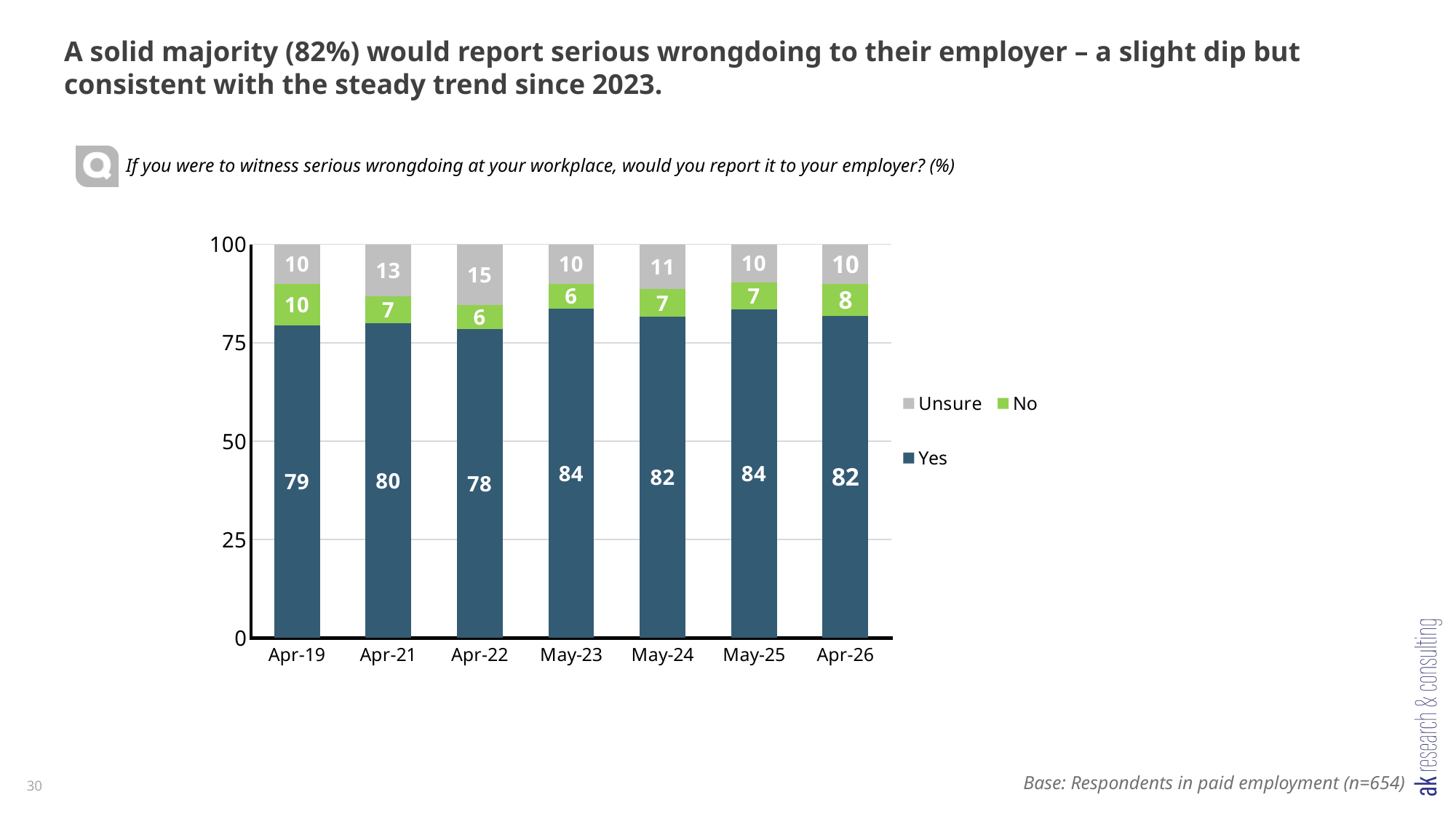
What is the total of the stacked bar for May-25? 101 In which period was the Yes value lowest? Apr-22 What kind of chart is shown on the slide? Stacked bar chart Which is larger, the Yes value for Apr-21 or the Yes value for May-24? May-24 What percentage answered Yes in Apr-26? 82 What is the Unsure value for Apr-22? 15 How many series does the legend list? 3 What is the No value for Apr-19? 10 What is the difference between the Yes value in May-25 and the Yes value in Apr-26? 2 Is the Yes value for May-23 greater or less than 75? greater In which period was the Unsure value highest? Apr-22 How many time periods are shown on the x axis? 7